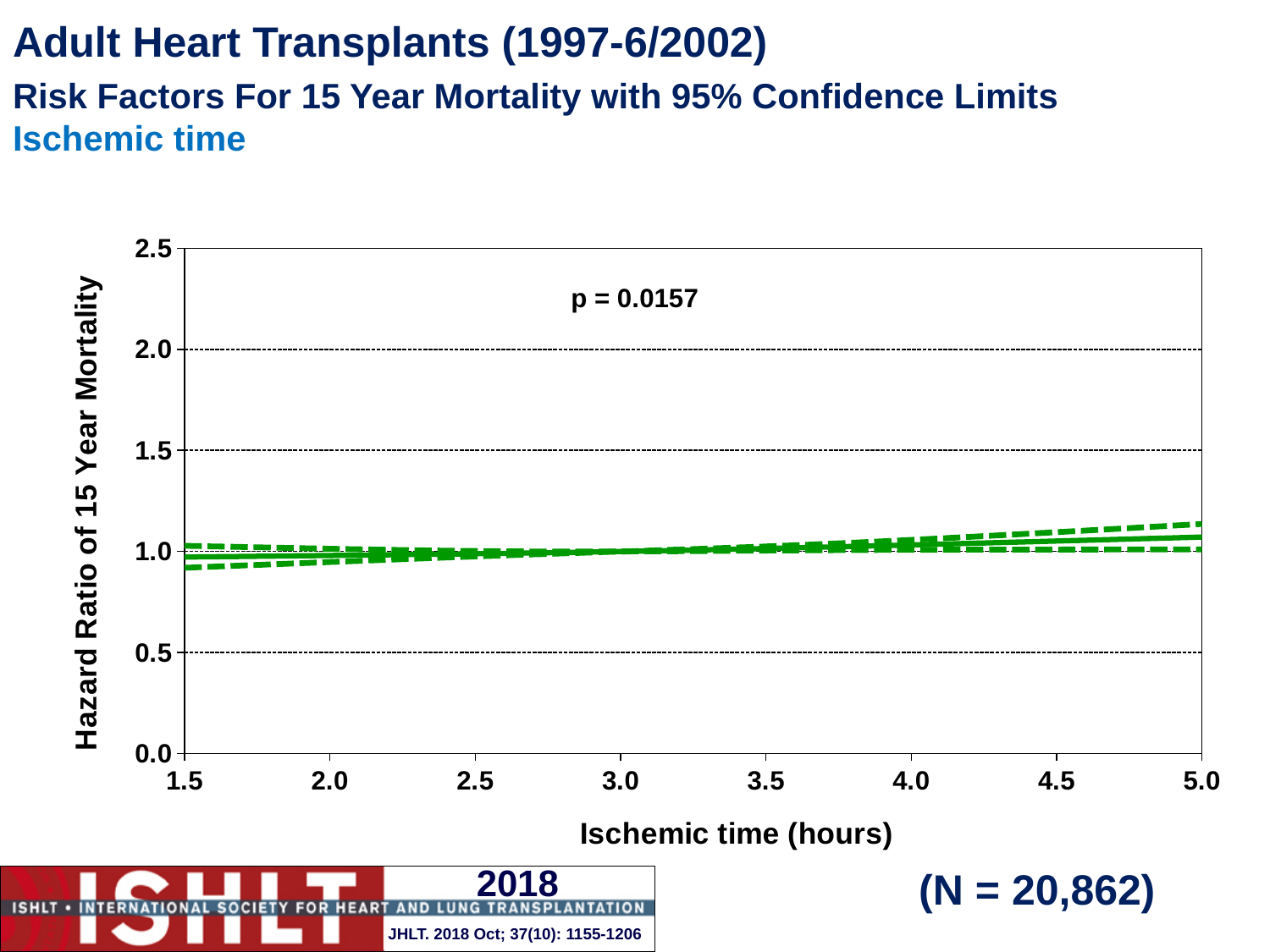
What p-value is printed on the chart? p = 0.0157 At which ischemic time shown on the x axis is the hazard ratio highest? 5.0 hours Which has the larger hazard ratio: an ischemic time of 1.5 hours or 5.0 hours? 5.0 hours What kind of chart is shown on the slide? line chart How many lines (solid and dashed) are plotted on the chart? 3 What is the label of the x axis? Ischemic time (hours) Is the upper 95% confidence limit at an ischemic time of 5.0 hours greater or less than 1.5? less Is the hazard ratio at an ischemic time of 1.5 hours greater or less than 0.5? greater At which ischemic time shown on the x axis is the hazard ratio lowest? 1.5 hours Is the hazard ratio at an ischemic time of 3.0 hours greater or less than 2.0? less Does the hazard ratio of 15 year mortality rise or fall as ischemic time increases from 1.5 to 5.0 hours? rise